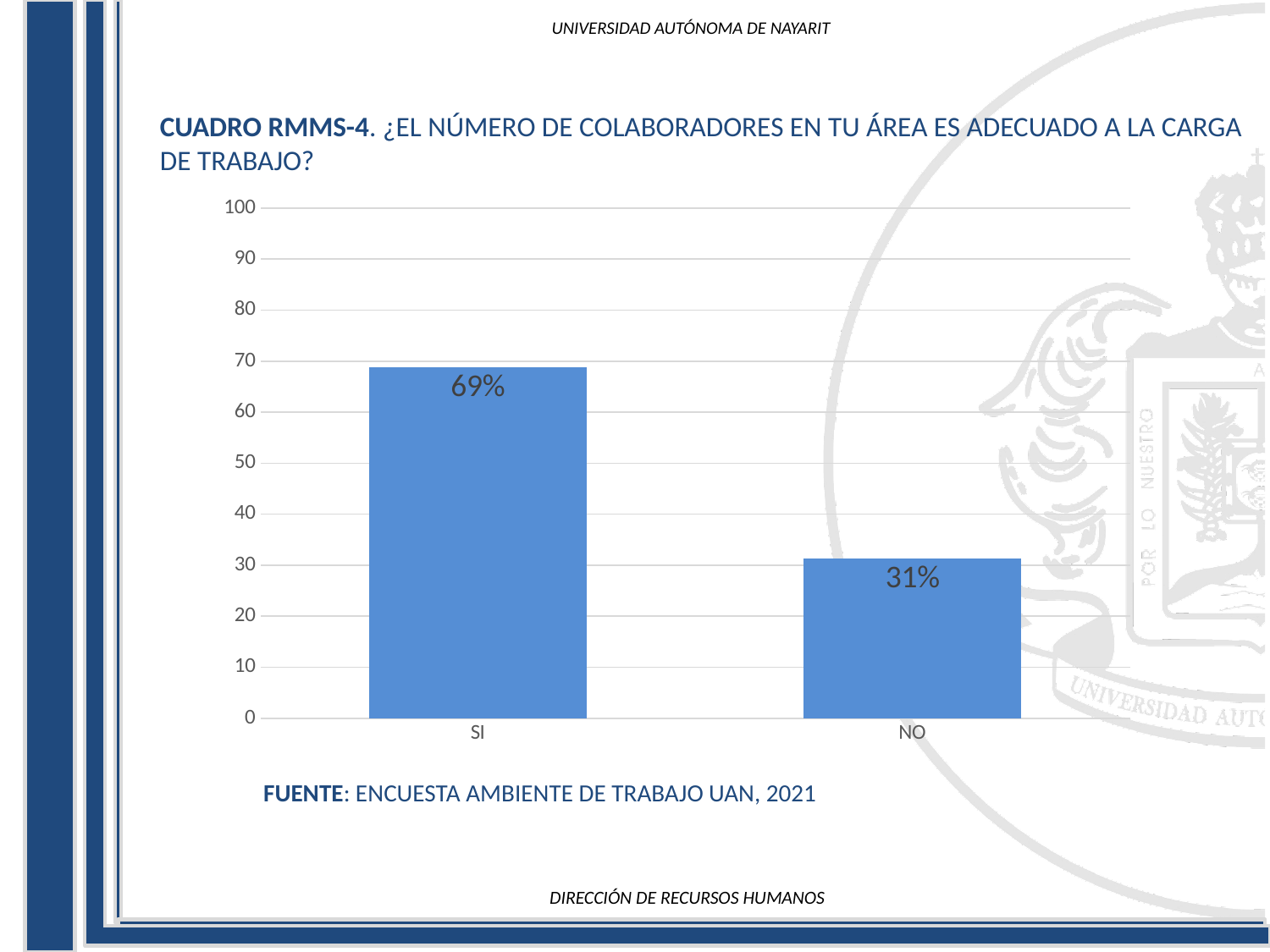
How many categories are shown on the x axis? 2 What is the difference between the values for SI and NO? 38% Is the value for SI greater or less than 60? greater What kind of chart is shown on the slide? bar chart What is the maximum value shown on the y axis? 100 What source is cited below the chart? ENCUESTA AMBIENTE DE TRABAJO UAN, 2021 What is the value for SI? 69% Is the value for NO greater or less than 40? less Which is larger, the value for SI or the value for NO? SI What is the value for NO? 31% Which category has the highest value? SI Which category has the lowest value? NO